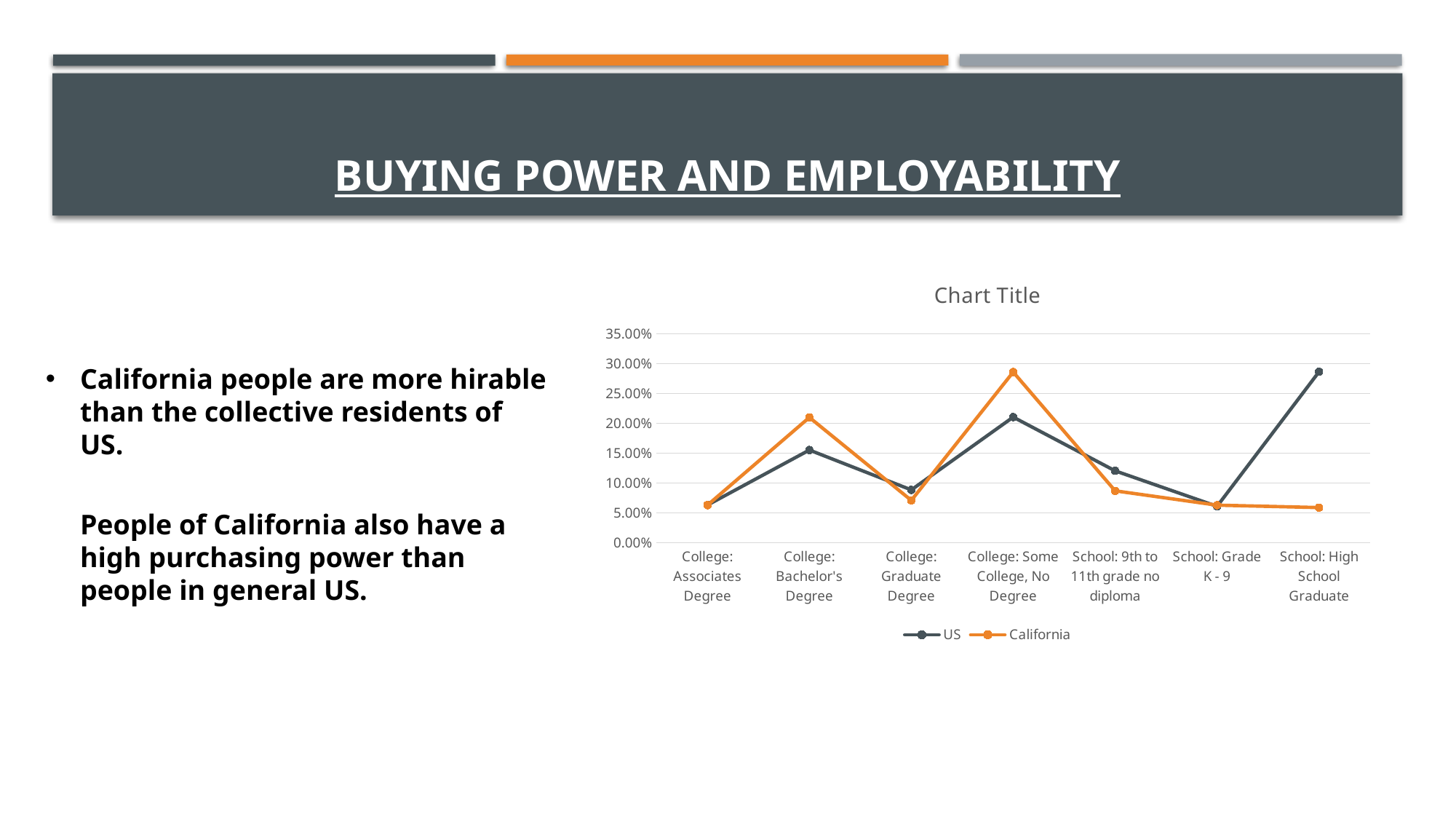
For the California series, which category has the highest value? College: Some College, No Degree Is the California value for School: High School Graduate greater or less than 10.00%? less Is the California value for College: Some College, No Degree greater or less than 25.00%? greater What kind of chart is shown on the slide? Line chart For the US series, which category has the highest value? School: High School Graduate How many series does the chart's legend list? 2 For College: Bachelor's Degree, which series has the larger value, US or California? California What colour is the line for the California series? Orange Is the US value for School: High School Graduate greater or less than 25.00%? greater For School: High School Graduate, which series has the larger value, US or California? US How many education categories are plotted along the x axis? 7 What is the title shown above the chart? Chart Title